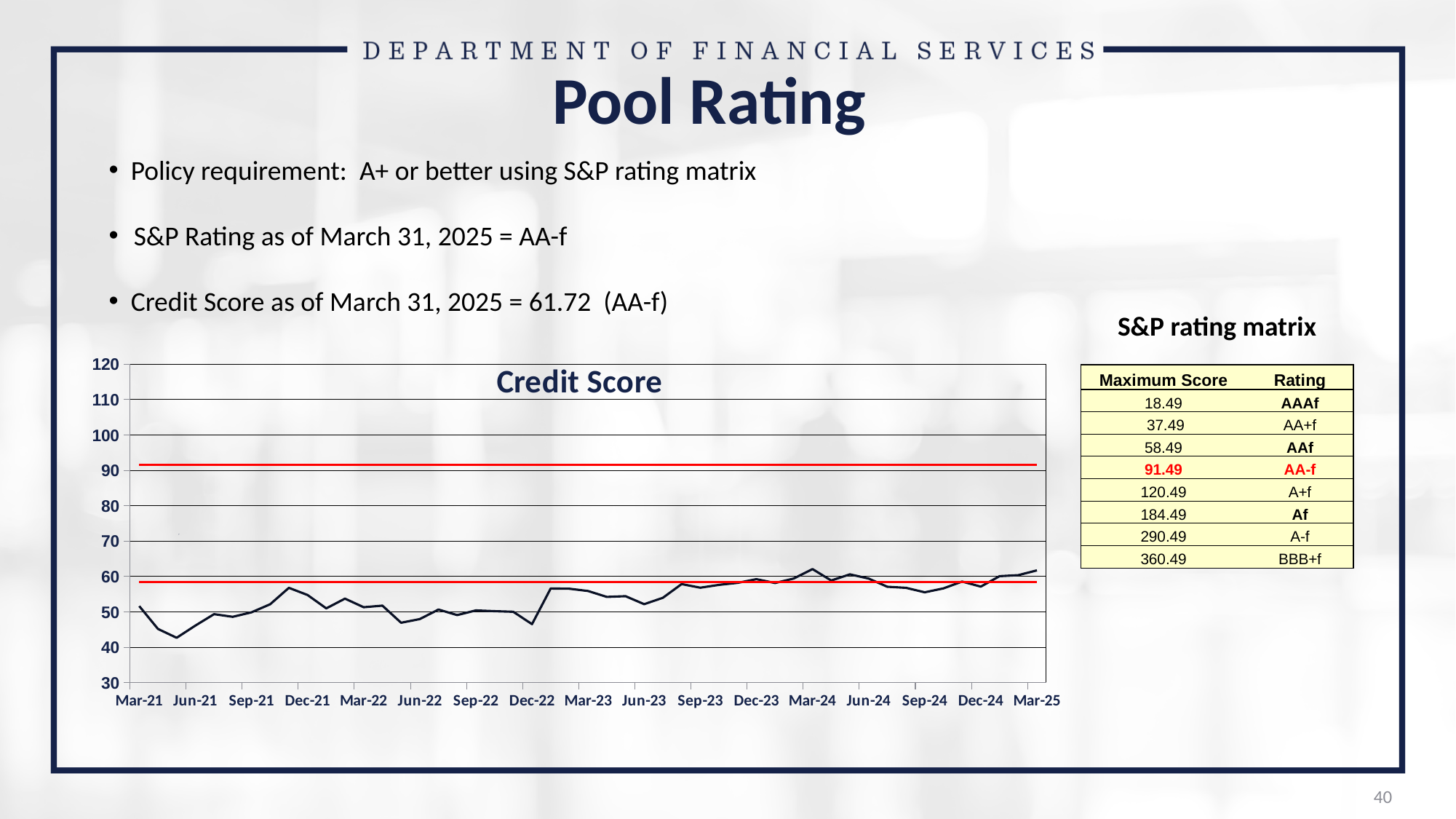
How many quarter labels are shown on the x axis of the Credit Score chart? 17 In the Credit Score chart, is the value for Jun-21 greater or less than 50? less In the Credit Score chart, does the credit score rise or fall between Mar-21 and Jun-21? fall In the Credit Score chart, which is larger, the value for Jun-21 or the value for Mar-24? Mar-24 In the Credit Score chart, is the value for Dec-22 greater or less than 50? less In the Credit Score chart, is the value for Mar-24 greater or less than 60? greater What is the highest value shown on the y axis of the Credit Score chart? 120 What is the title of the chart on the slide? Credit Score In the Credit Score chart, which is larger, the value for Dec-21 or the value for Dec-22? Dec-21 What kind of chart is the Credit Score chart? line chart In the Credit Score chart, which labelled quarter has the lowest credit score? Jun-21